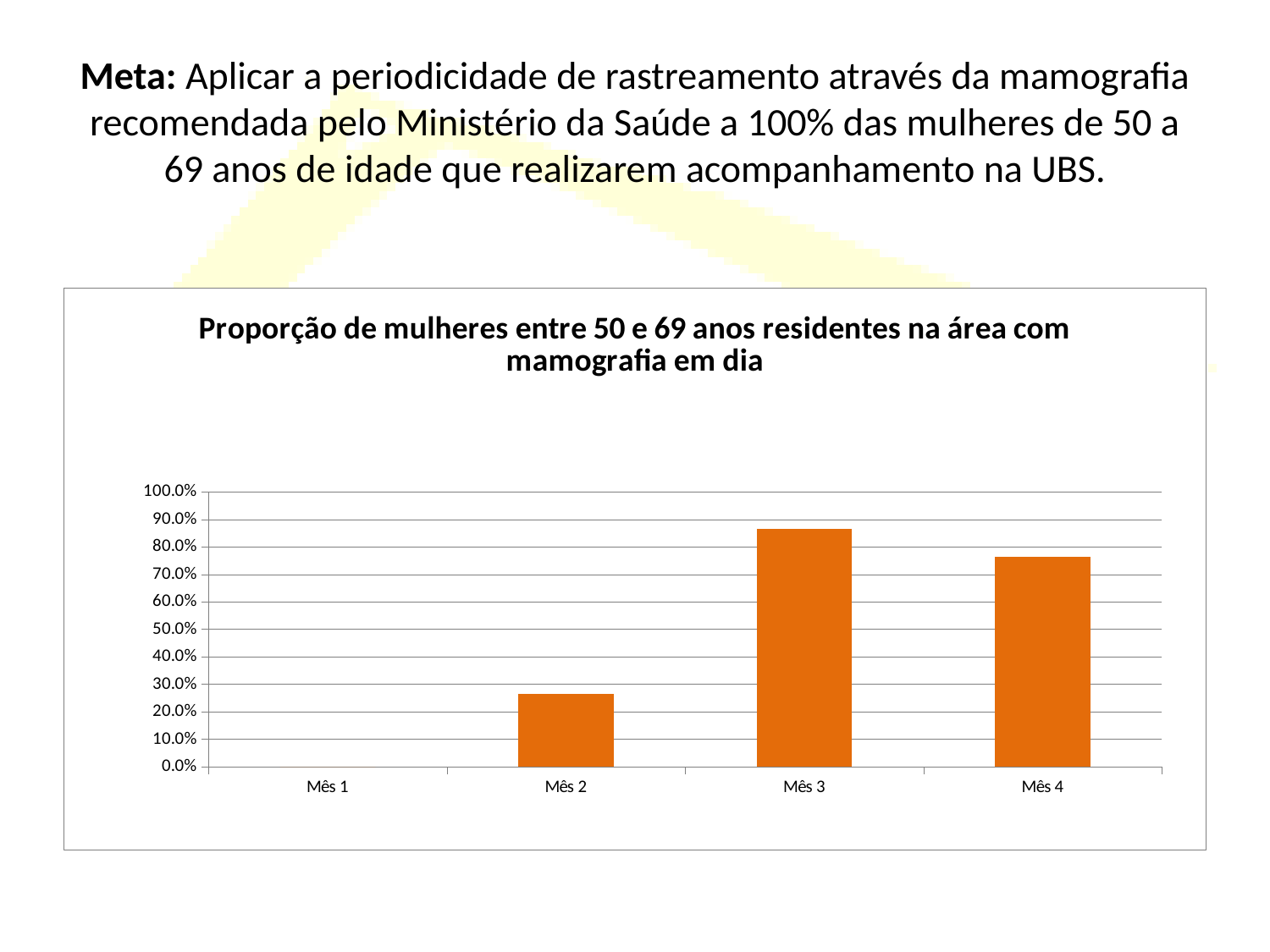
Which is larger, the value for Mês 3 or the value for Mês 4? Mês 3 Which is larger, the value for Mês 2 or the value for Mês 4? Mês 4 How many months (categories) are shown on the x axis of the chart? 4 Is the value for Mês 2 greater or less than 20.0%? greater What is the title of the chart? Proporção de mulheres entre 50 e 69 anos residentes na área com mamografia em dia Which month has the highest proportion of women with mammography up to date? Mês 3 What kind of chart is shown on the slide? bar chart Is the value for Mês 3 greater or less than 80.0%? greater Which month has the lowest value in the chart? Mês 1 Is the value for Mês 4 greater or less than 70.0%? greater Does the value rise or fall from Mês 3 to Mês 4? fall